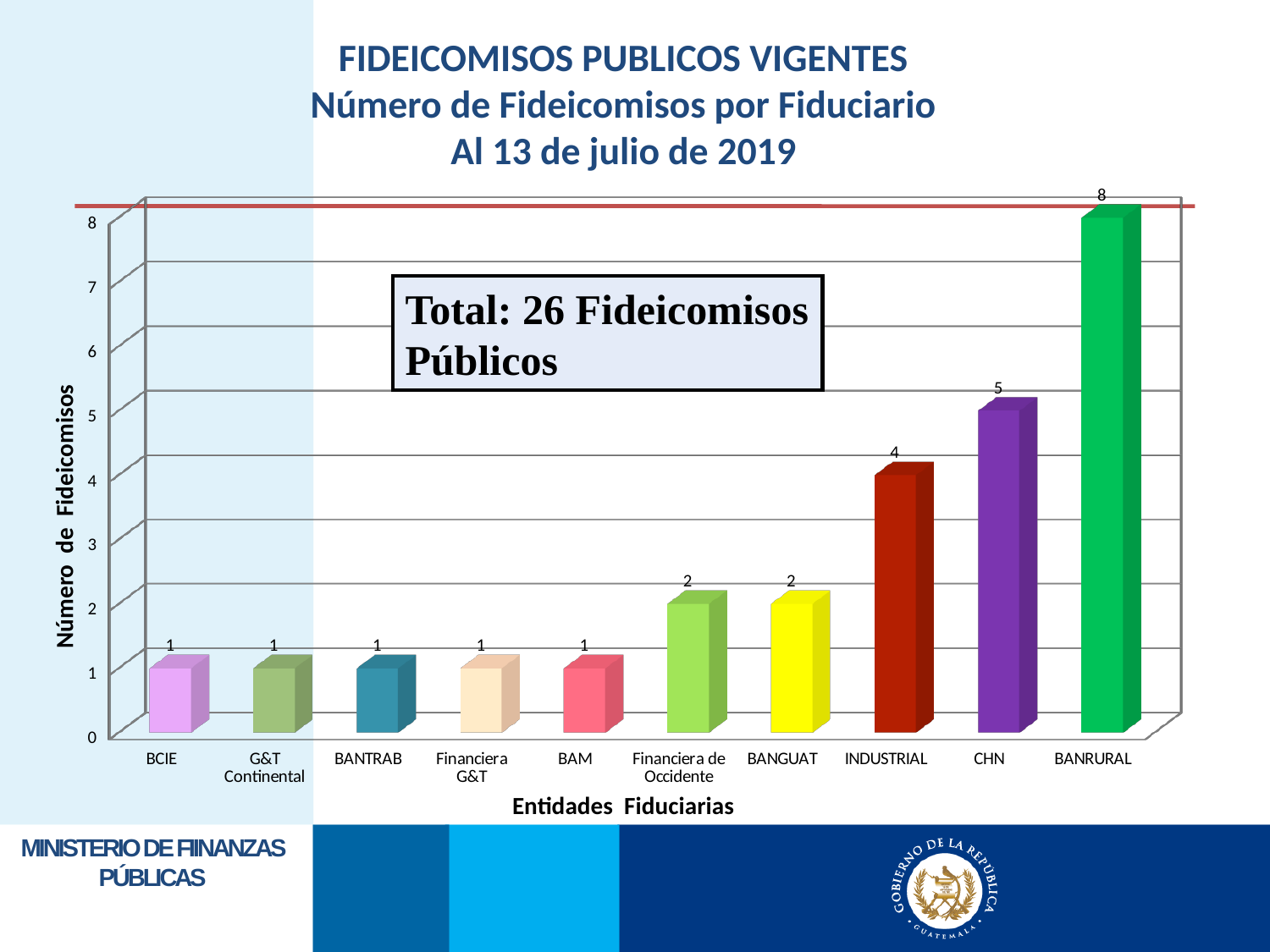
What is the value for BANGUAT? 2 How many entities (categories) are shown on the x axis? 10 What is the value for CHN? 5 How many fideicomisos does BANRURAL have? 8 Which entity has the highest number of fideicomisos? BANRURAL Do the values generally rise or fall from left to right along the x axis? Rise What is the difference between the values for BANRURAL and CHN? 3 What kind of chart is shown on the slide? Bar chart What is the value for INDUSTRIAL? 4 Which is larger, the value for INDUSTRIAL or the value for Financiera de Occidente? INDUSTRIAL What total number of fideicomisos públicos is stated in the text box on the chart? 26 How many entities have a value of 1? 5